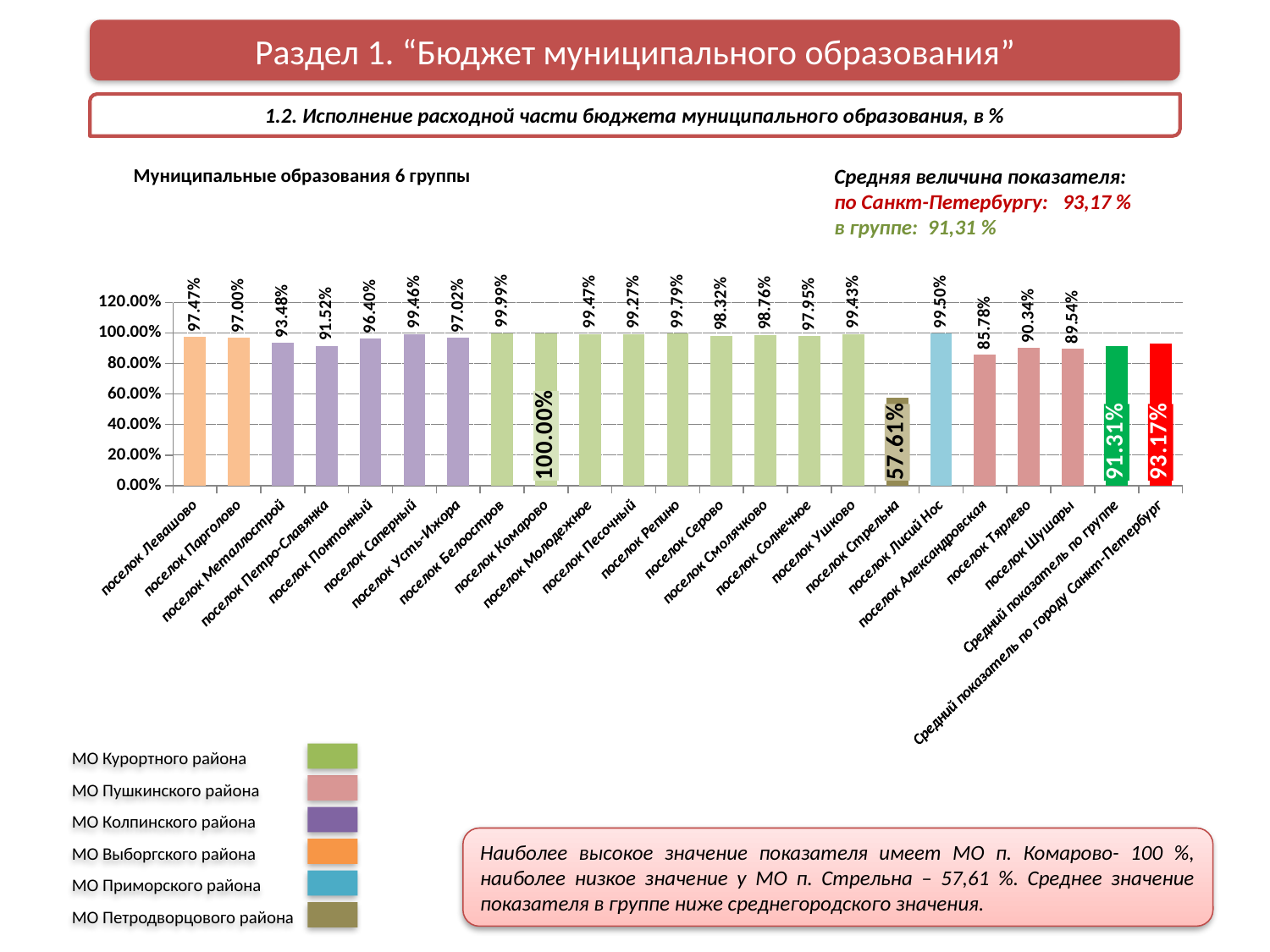
Which category has the lowest value? поселок Стрельна What is the value for поселок Лисий Нос? 99.50% What is the difference between the values for поселок Комарово and поселок Стрельна? 42.39% Which is larger, the value for поселок Тярлево or поселок Шушары? поселок Тярлево How many bars are plotted in the chart? 23 Which category has the highest value? поселок Комарово What is the value shown for Средний показатель по группе? 91.31% Is the value for поселок Стрельна greater or less than 60.00%? less What is the value for поселок Александровская? 85.78% What is the difference between Средний показатель по городу Санкт-Петербург and Средний показатель по группе? 1.86% What is the value for поселок Стрельна? 57.61% What kind of chart is shown on the slide? bar chart